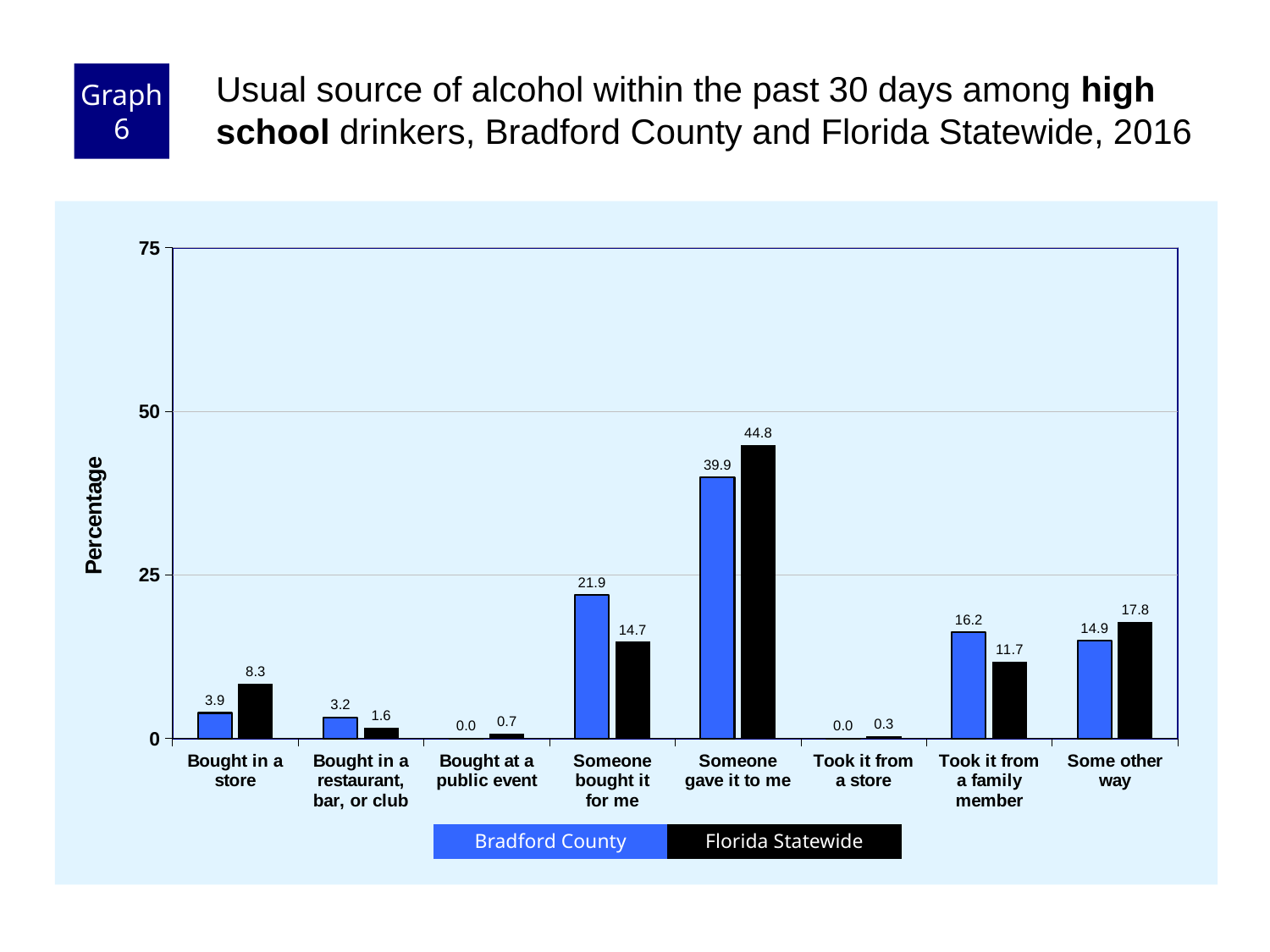
Which is larger for "Some other way": Bradford County or Florida Statewide? Florida Statewide What is the difference between the Florida Statewide and Bradford County values for "Someone gave it to me"? 4.9 Which category has the highest Florida Statewide value? Someone gave it to me How many series does the legend list? 2 What kind of chart is shown on the slide? Bar chart What is the Bradford County value for "Someone gave it to me"? 39.9 What is the Florida Statewide value for "Bought in a store"? 8.3 How many categories are shown on the x axis? 8 Is the Bradford County value for "Someone gave it to me" greater or less than 25? greater Which category has the lowest Florida Statewide value? Took it from a store What is the Bradford County value for "Took it from a family member"? 16.2 What is the difference between the Bradford County and Florida Statewide values for "Someone bought it for me"? 7.2